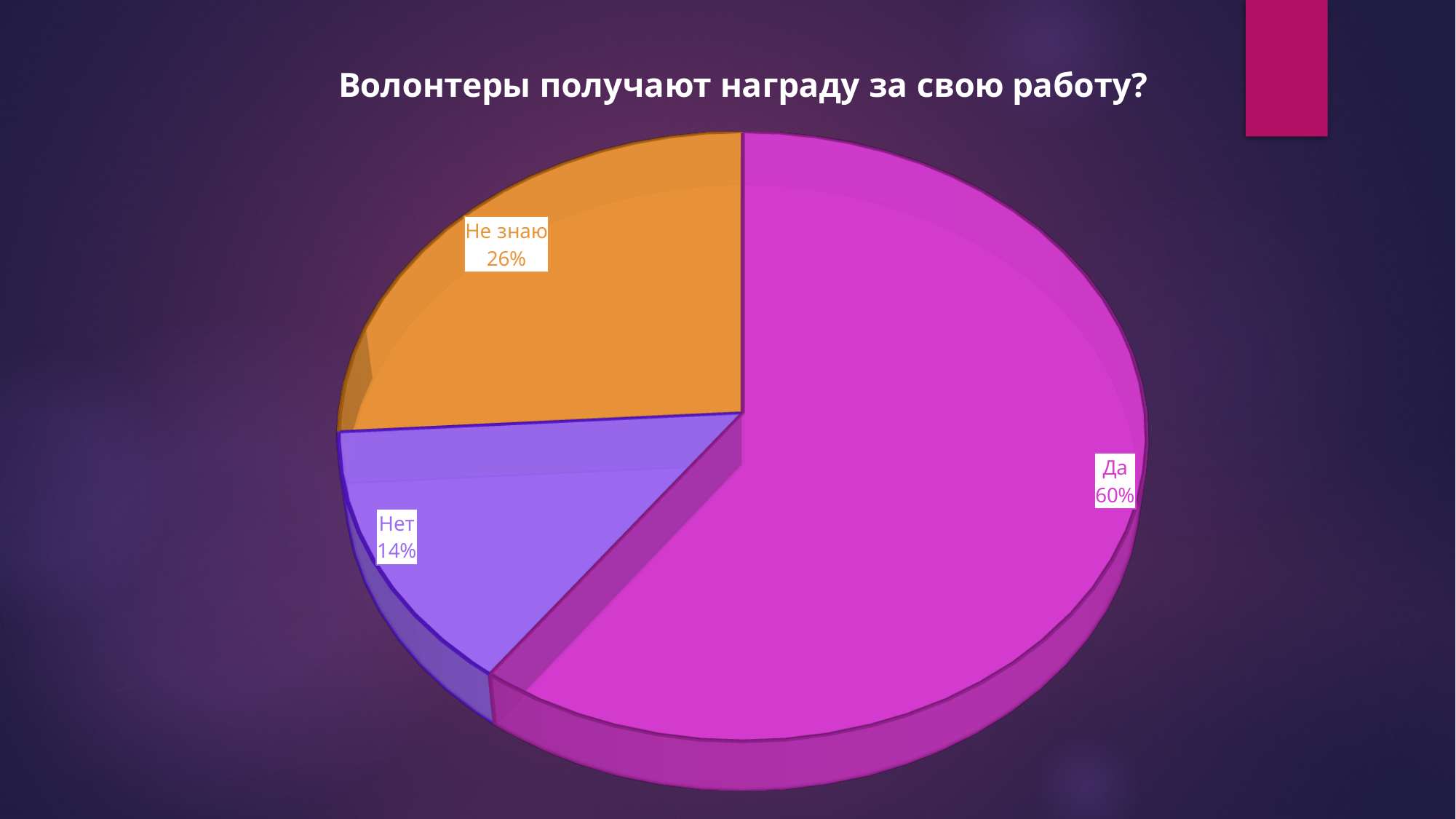
What is the title of the chart? Волонтеры получают награду за свою работу? What share of the pie does "Да" take? 60% What is the difference in percentage points between "Да" and "Не знаю"? 34 What is the difference in percentage points between "Не знаю" and "Нет"? 12 What colour is the "Не знаю" slice? orange What share of the pie does "Не знаю" take? 26% Which category has the largest slice? Да Which is larger, the share for "Не знаю" or the share for "Нет"? Не знаю How many slices does the pie chart have? 3 What share of the pie does "Нет" take? 14% Which category has the smallest slice? Нет What kind of chart is shown on the slide? pie chart